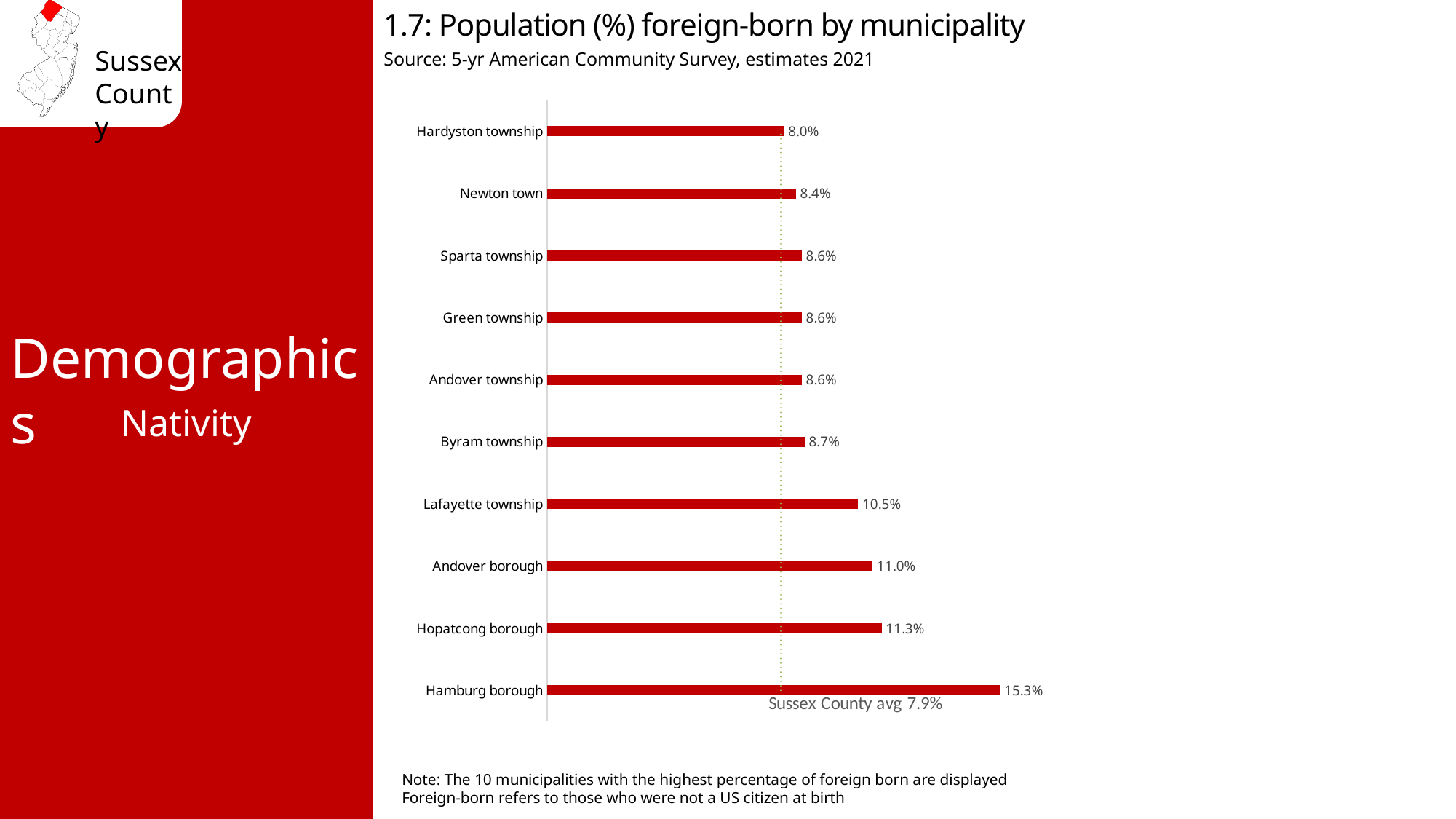
What kind of chart is used to show the foreign-born population by municipality? Bar chart What is the source of the data shown in the chart? 5-yr American Community Survey, estimates 2021 Which has a higher foreign-born percentage, Andover borough or Byram township? Andover borough How many municipalities are shown on the chart? 10 What is the difference between the foreign-born percentages of Hamburg borough and Hopatcong borough? 4.0% What is the difference between the foreign-born percentages of Hardyston township and the Sussex County average? 0.1% What is the Sussex County average percentage of foreign-born population shown on the chart? 7.9% What is the percentage of foreign-born population for Hamburg borough? 15.3% Which municipality has the highest percentage of foreign-born population? Hamburg borough What is the percentage of foreign-born population for Lafayette township? 10.5% What is the percentage of foreign-born population for Newton town? 8.4% Which municipality has the lowest percentage of foreign-born population shown on the chart? Hardyston township